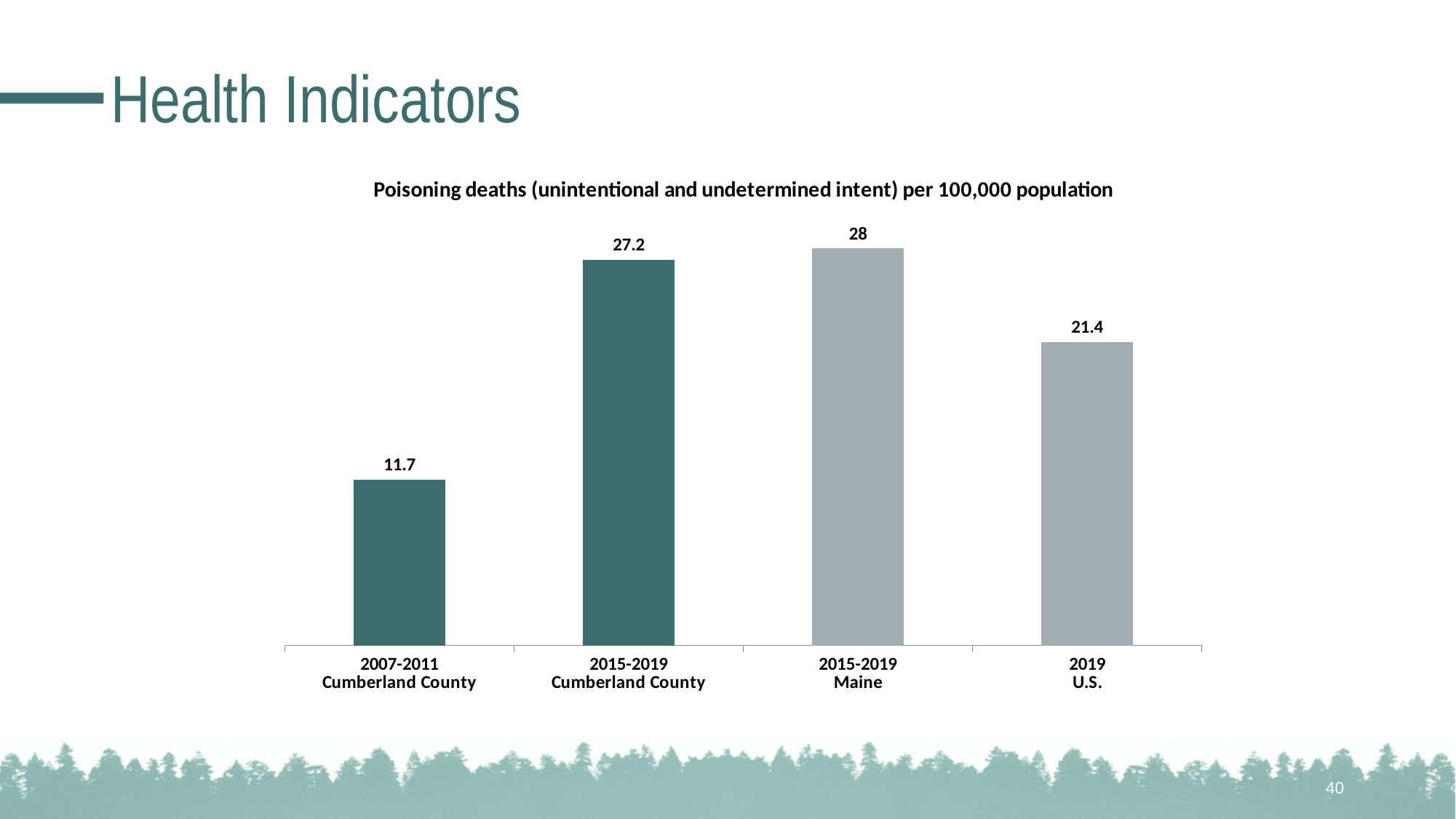
What is the poisoning death rate per 100,000 population for Maine in 2015-2019? 28 What is the poisoning death rate per 100,000 population for Cumberland County in 2015-2019? 27.2 How many bars are shown in the chart? 4 Which is larger, the 2015-2019 Cumberland County rate or the 2019 U.S. rate? 2015-2019 Cumberland County What type of chart is shown on the slide? Bar chart Which category has the highest poisoning death rate? 2015-2019 Maine What is the title of the chart? Poisoning deaths (unintentional and undetermined intent) per 100,000 population What is the poisoning death rate per 100,000 population for Cumberland County in 2007-2011? 11.7 By how much did the poisoning death rate in Cumberland County increase from 2007-2011 to 2015-2019? 15.5 Which category has the lowest poisoning death rate? 2007-2011 Cumberland County What is the poisoning death rate per 100,000 population for the U.S. in 2019? 21.4 What is the difference between the 2015-2019 Maine rate and the 2019 U.S. rate? 6.6